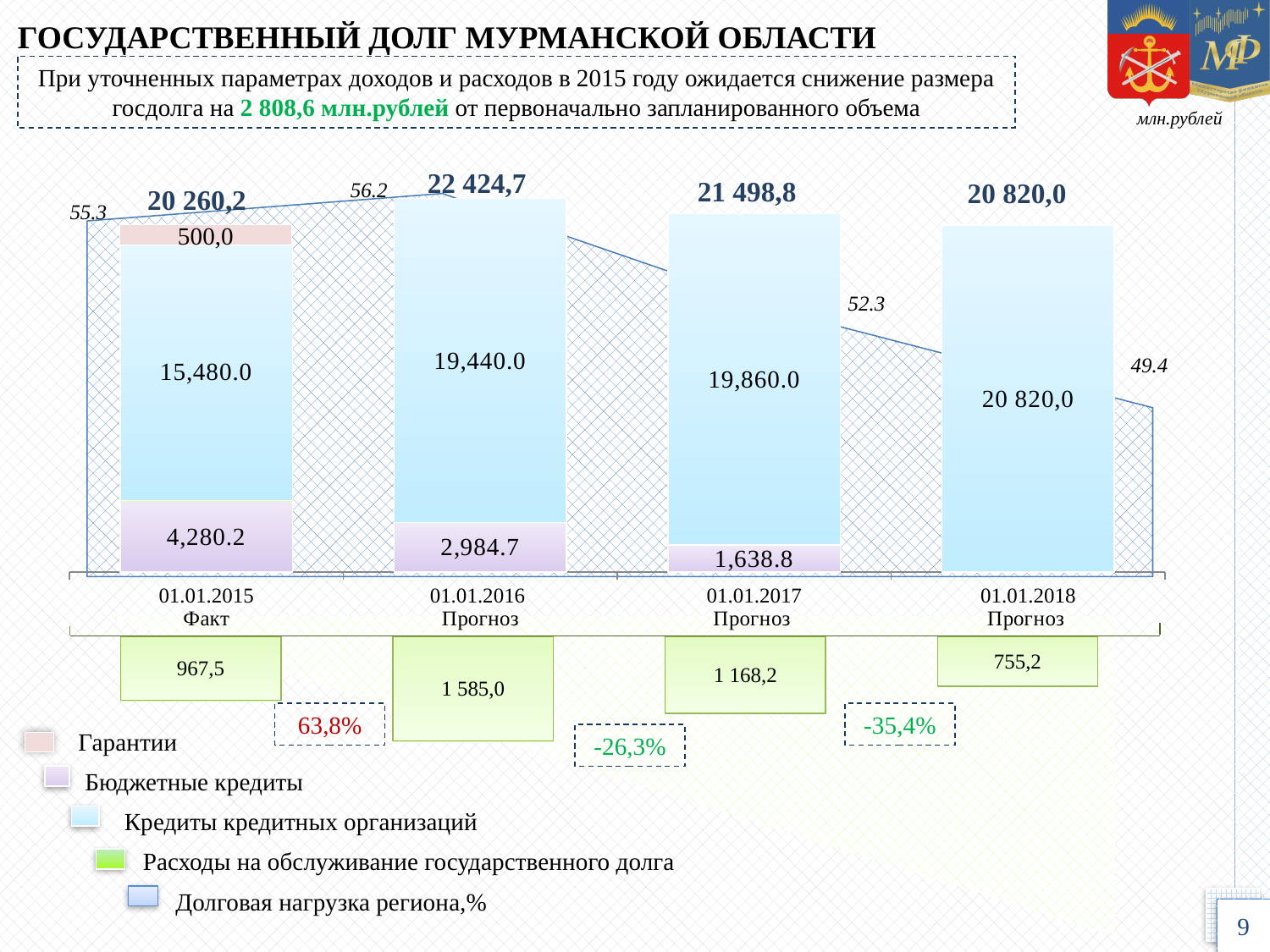
What is the Долговая нагрузка региона,% value for 01.01.2018? 49.4 What is the value of Расходы на обслуживание государственного долга for 01.01.2016? 1 585,0 How many entries does the legend list? 5 How many dates are shown on the x axis of the chart? 4 What is the total state debt shown for 01.01.2016? 22 424,7 What kind of chart is used to show the state debt? Stacked bar chart Which is larger, the Кредиты кредитных организаций value for 01.01.2016 or for 01.01.2018? 01.01.2018 What is the value of Гарантии for 01.01.2015? 500,0 On which date is the Бюджетные кредиты value lowest? 01.01.2017 On which date is the total state debt highest? 01.01.2016 What is the value of Бюджетные кредиты for 01.01.2015? 4,280.2 What is the value of Кредиты кредитных организаций for 01.01.2017? 19,860.0